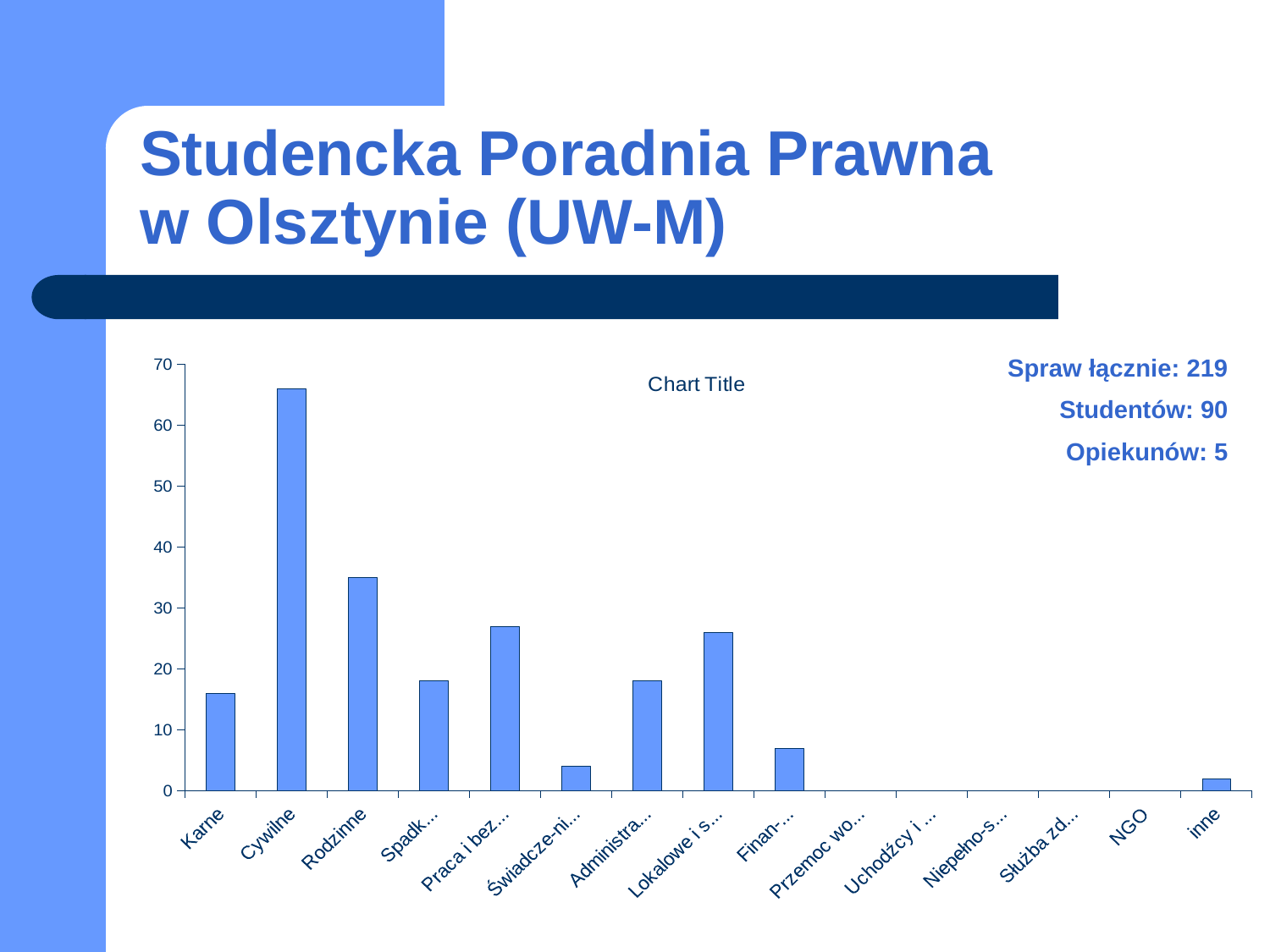
Which category has the highest bar in the chart? Cywilne What is the title shown on the chart? Chart Title Which is larger, the value for Cywilne or the value for Rodzinne? Cywilne Is the value for Karne greater or less than 10? greater What kind of chart is shown on the slide? bar chart Is the value for Cywilne greater or less than 60? greater Which is larger, the value for Karne or the value for NGO? Karne How many categories are shown along the x axis of the chart? 15 Which is larger, the value for Karne or the value for Rodzinne? Rodzinne Is the value for Rodzinne greater or less than 30? greater